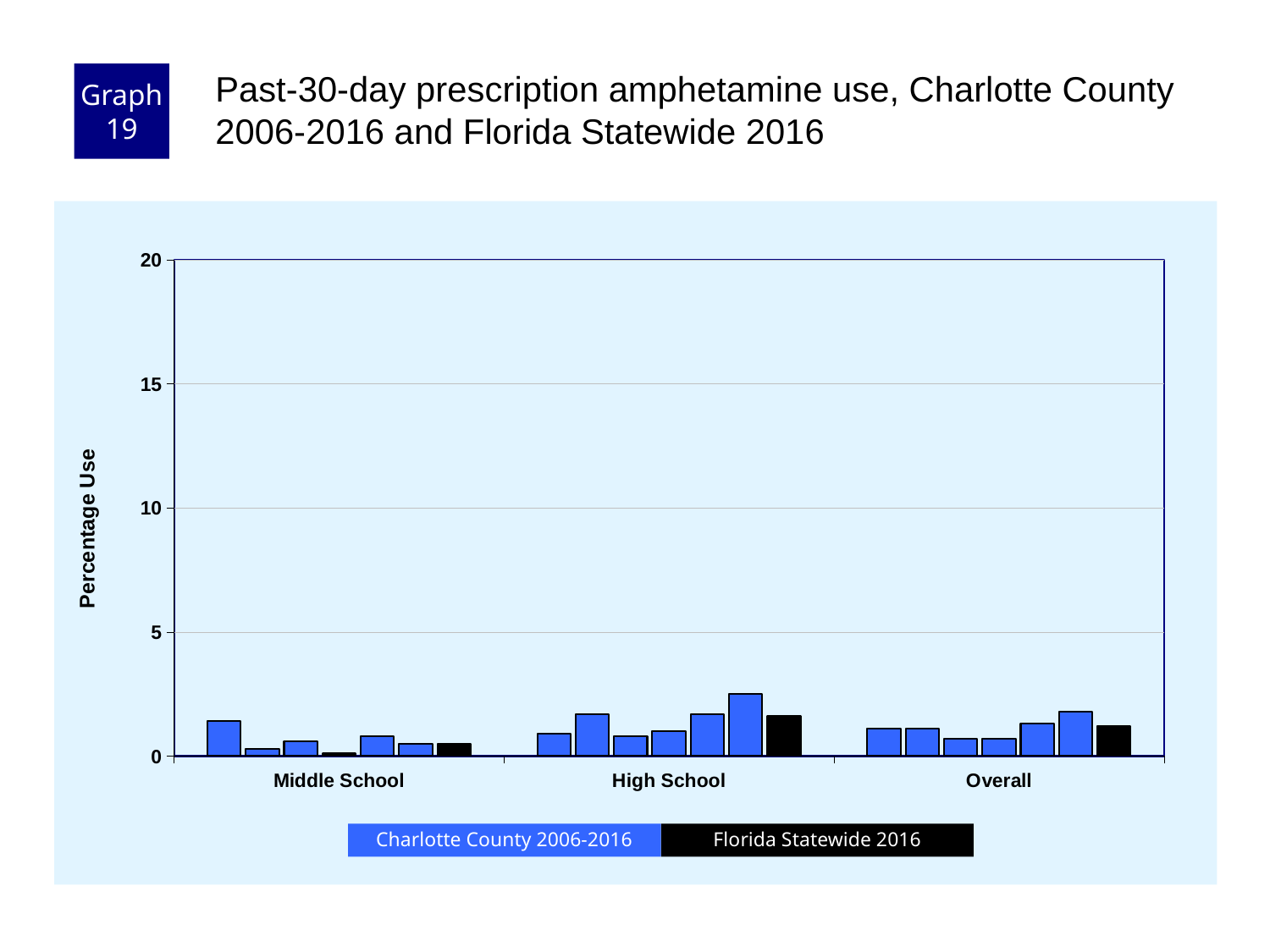
Is the tallest bar in the High School group greater or less than 5? less Which category group contains the tallest bar on the chart? High School How many series does the legend list? 2 How many categories are shown on the x axis? 3 What kind of chart is shown on the slide? bar chart Which category group has the lowest Florida Statewide 2016 value? Middle School Which is larger: the Florida Statewide 2016 value for High School or for Middle School? High School Is the Florida Statewide 2016 value for Middle School greater or less than 5? less Which colour represents Florida Statewide 2016 in the legend? black Which is larger: the Florida Statewide 2016 value for Overall or for Middle School? Overall What is the label on the y axis? Percentage Use Is the Florida Statewide 2016 value for High School greater or less than 5? less